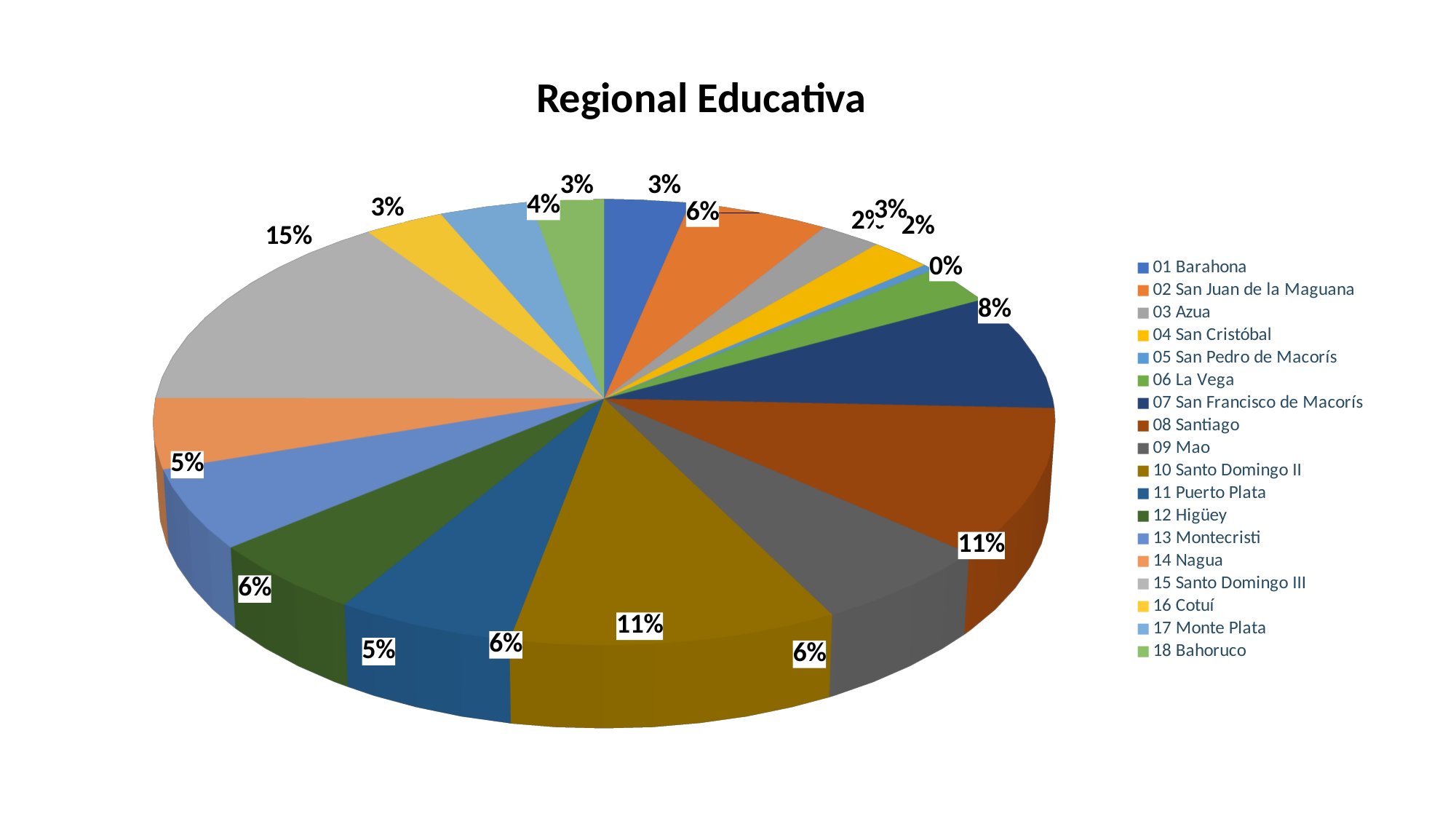
Which is larger, the share for 15 Santo Domingo III or the share for 08 Santiago? 15 Santo Domingo III What is the value shown for 14 Nagua? 5% What share of the pie does 15 Santo Domingo III have? 15% How many categories does the legend of the pie chart list? 18 Which category has the largest share of the pie? 15 Santo Domingo III What is the difference in percentage points between 15 Santo Domingo III and 07 San Francisco de Macorís? 7 percentage points What is the value shown for 17 Monte Plata? 4% What kind of chart is shown on the slide? pie chart What share of the pie does 07 San Francisco de Macorís have? 8% What is the value shown for 02 San Juan de la Maguana? 6% What is the title of the chart? Regional Educativa What share of the pie does 08 Santiago have? 11%